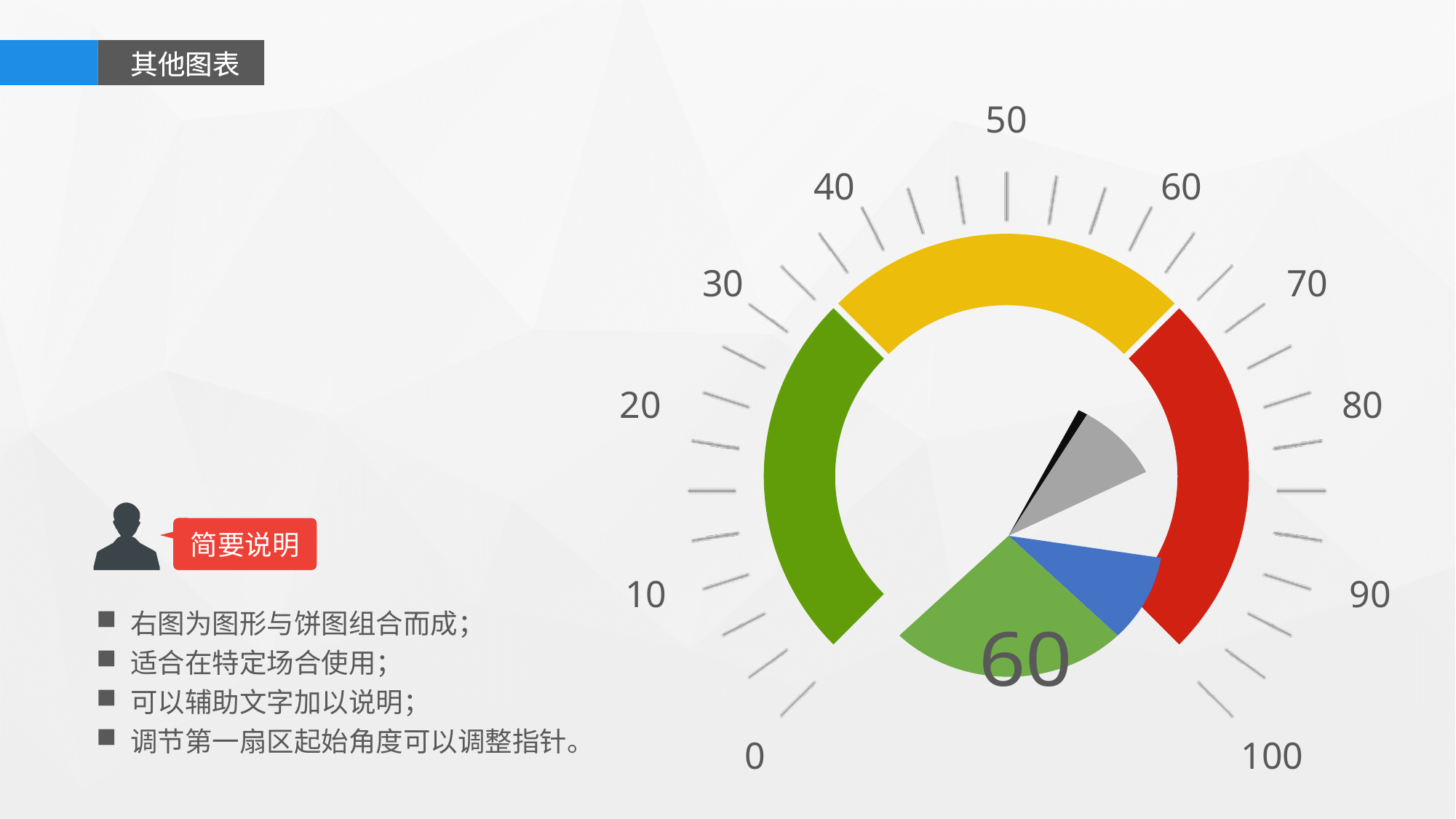
Is the value shown on the gauge greater or less than 70? less What value does the gauge chart display? 60 How many coloured zones make up the gauge's outer arc? 3 What is the difference between the highest and lowest values marked on the gauge scale? 100 What colour is the zone of the gauge arc that the needle points into? yellow What is the lowest value marked on the gauge scale? 0 How many numbered tick labels are on the gauge scale? 11 What is the highest value marked on the gauge scale? 100 What kind of chart is shown on the slide? gauge chart What is the value marked at the top centre of the gauge scale? 50 Is the value shown on the gauge greater or less than 50? greater What colour is the gauge arc zone nearest the 100 end of the scale? red